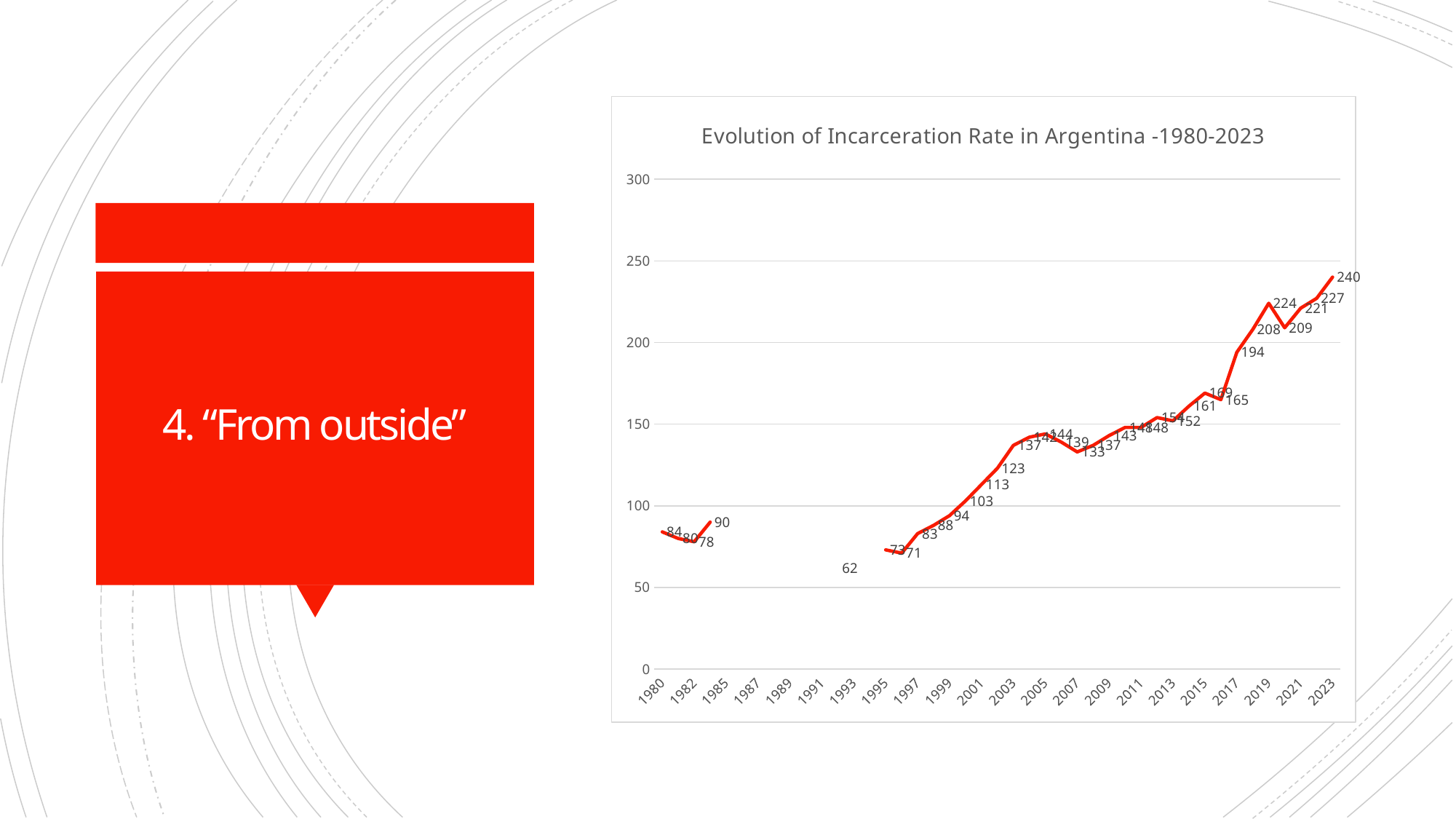
What is the incarceration rate value shown for 2023? 240 Which year has the highest incarceration rate on the chart? 2023 Overall, do the values rise or fall from 1995 to 2023? rise What is the title of the chart? Evolution of Incarceration Rate in Argentina -1980-2023 What is the incarceration rate value shown for 1980? 84 What is the lowest data label value shown on the chart? 62 What is the difference between the highest value (240) and the lowest labelled value (62)? 178 Is the value for 2017 greater or less than 150? greater What is the incarceration rate value shown for 2019? 224 What type of chart is shown on the slide? line chart Is the value for 2007 greater or less than 150? less Which year has the larger incarceration rate, 1980 or 2023? 2023